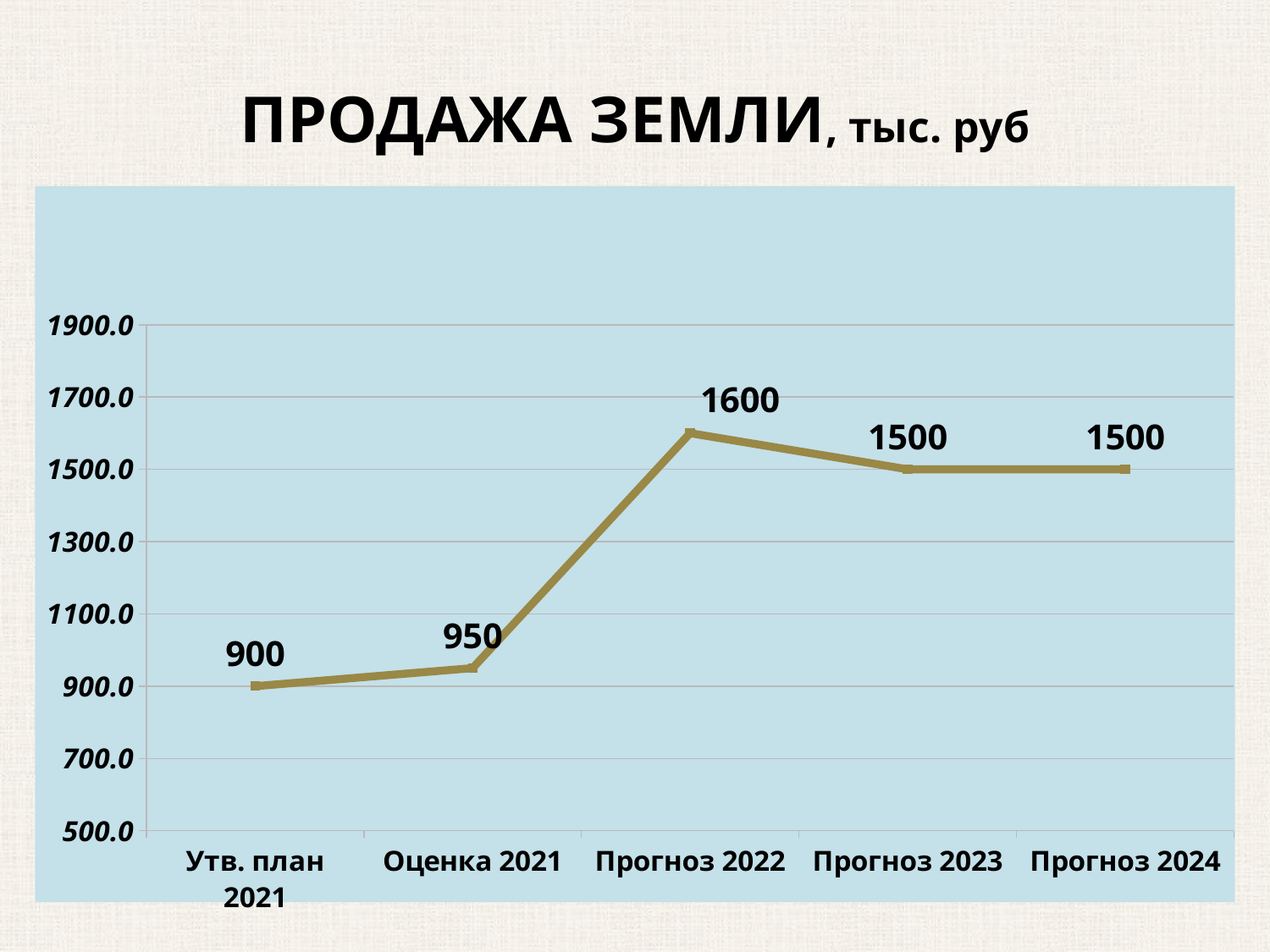
What is the value for Утв. план 2021? 900 What is the difference between the values for Оценка 2021 and Утв. план 2021? 50 What is the value for Прогноз 2024? 1500 Which category has the lowest value? Утв. план 2021 What is the value for Прогноз 2022? 1600 How many data points are plotted on the chart? 5 Which is larger, the value for Оценка 2021 or the value for Прогноз 2022? Прогноз 2022 What kind of chart is shown on the slide? line chart What is the title of the chart? ПРОДАЖА ЗЕМЛИ, тыс. руб What is the value for Оценка 2021? 950 Which category has the highest value? Прогноз 2022 What is the difference between the values for Прогноз 2022 and Прогноз 2023? 100